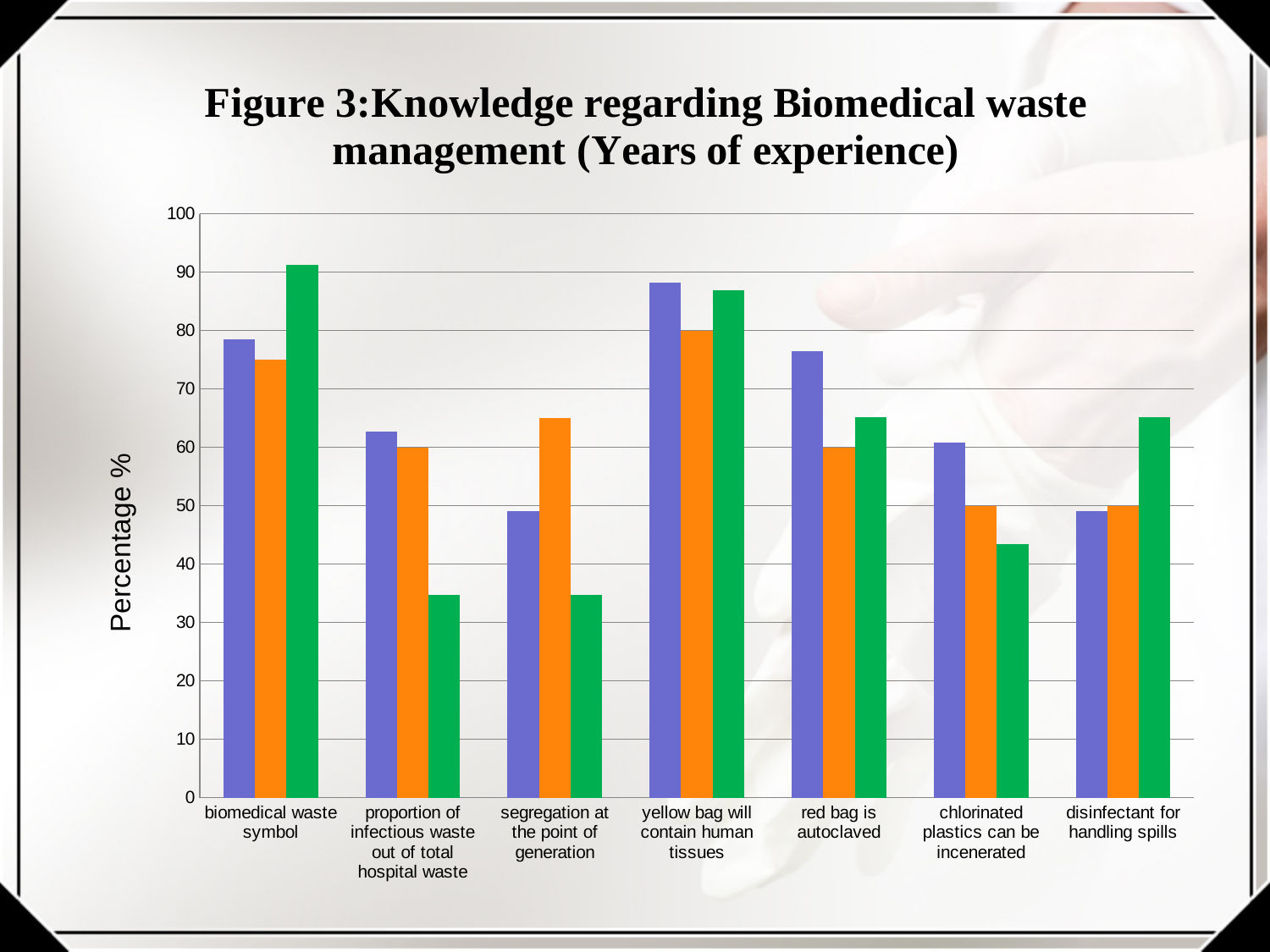
Is the blue bar for 'chlorinated plastics can be incenerated' greater or less than 50? greater Is the green bar for 'biomedical waste symbol' greater or less than 80? greater How many bars are plotted for each category? 3 What is the title of the chart? Figure 3:Knowledge regarding Biomedical waste management (Years of experience) What is the title of the y axis? Percentage % What kind of chart is shown on the slide? bar chart Among the green bars, which category has the highest value? biomedical waste symbol Among the blue bars, which category has the highest value? yellow bag will contain human tissues Is the green bar for 'proportion of infectious waste out of total hospital waste' greater or less than 40? less How many knowledge-item categories are shown along the x axis? 7 For 'segregation at the point of generation', which is larger: the orange bar or the blue bar? orange bar For 'red bag is autoclaved', which is larger: the blue bar or the green bar? blue bar